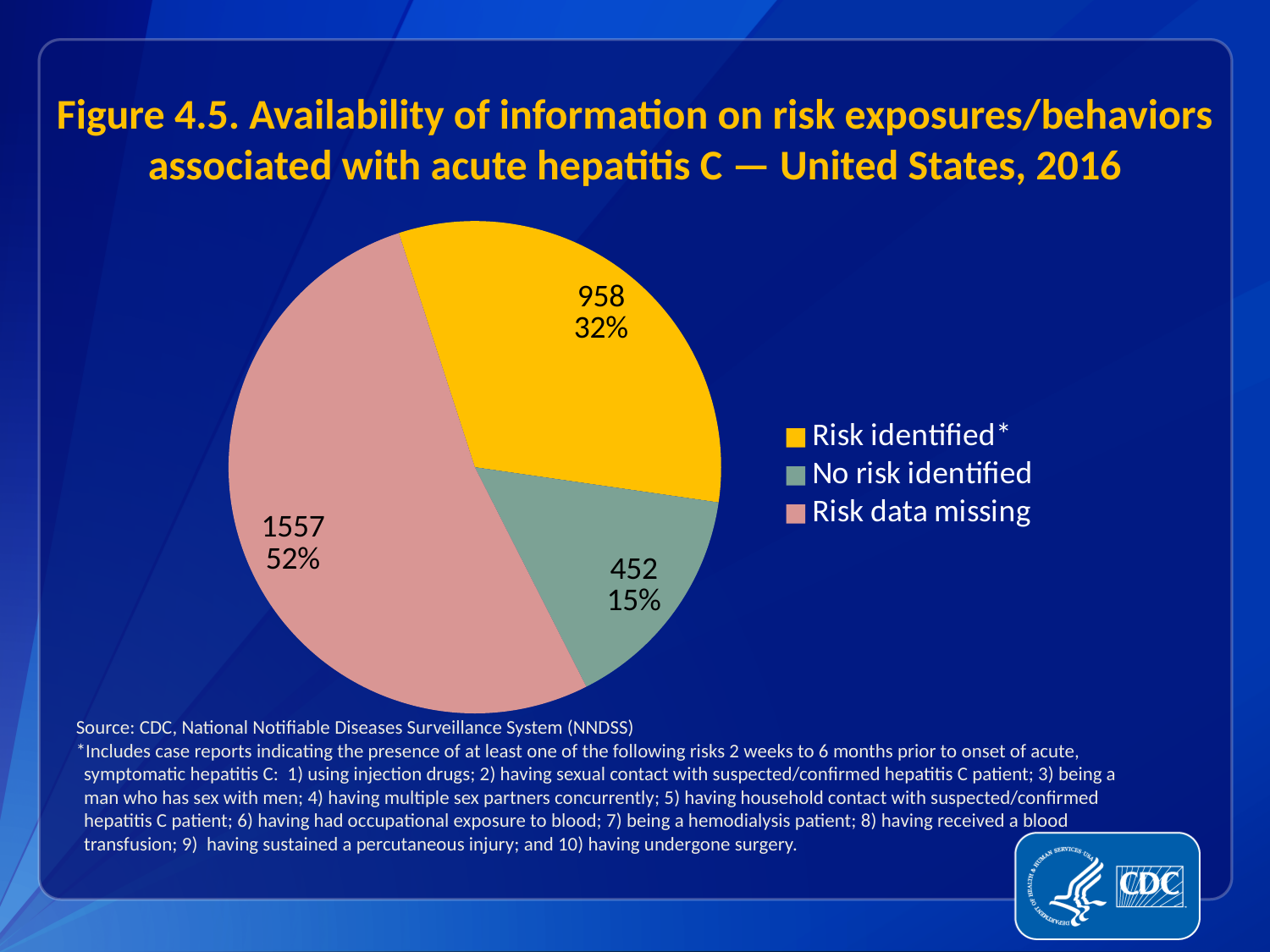
What is the total number of cases across all three slices? 2967 What is the difference in the number of cases between 'Risk data missing' and 'Risk identified*'? 599 Which is larger, the number of cases with risk identified or the number with no risk identified? Risk identified* How many cases are in the 'Risk data missing' slice? 1557 Which category has the largest slice of the pie? Risk data missing What share of the pie does 'Risk identified*' represent? 32% How many cases are in the 'Risk identified*' slice? 958 How many categories does the pie chart have? 3 What colour is the 'Risk data missing' slice? pink Which category has the smallest slice of the pie? No risk identified What kind of chart is shown on the slide? pie chart What percentage of cases had no risk identified? 15%